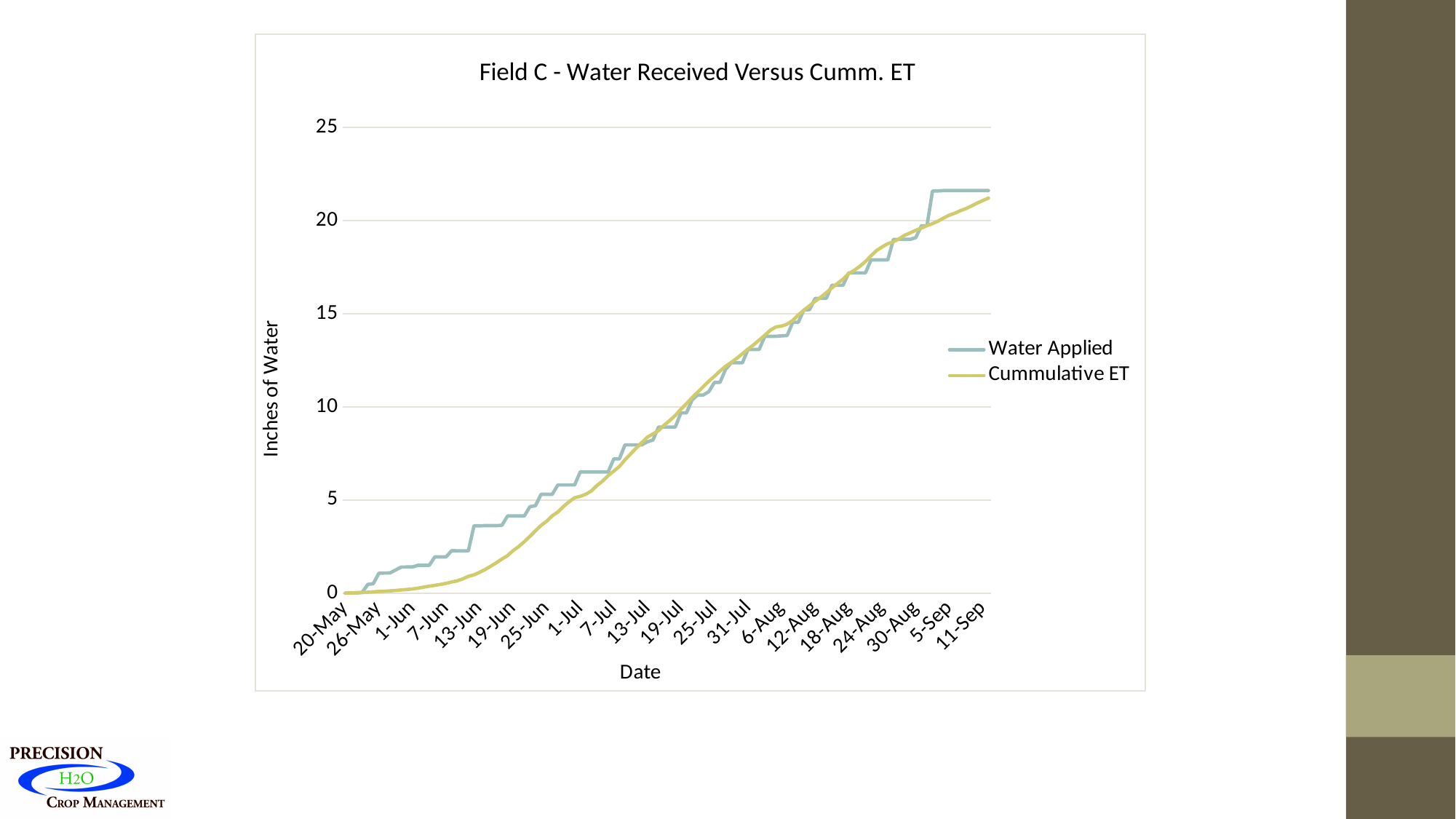
Is the Cummulative ET value on 13-Jun greater or less than 5? less On 5-Sep, which series has the larger value, Water Applied or Cummulative ET? Water Applied Is the Water Applied value on 11-Sep greater or less than 20? greater Do the Water Applied values rise or fall from 20-May to 11-Sep? Rise On 13-Jun, which series has the larger value, Water Applied or Cummulative ET? Water Applied How many series does the legend list? 2 What is the title of the chart? Field C - Water Received Versus Cumm. ET What kind of chart is shown on the slide? Line chart Do the Cummulative ET values rise or fall along the x axis? Rise Is the Cummulative ET value on 25-Jun greater or less than 5? less What is the label of the vertical axis? Inches of Water